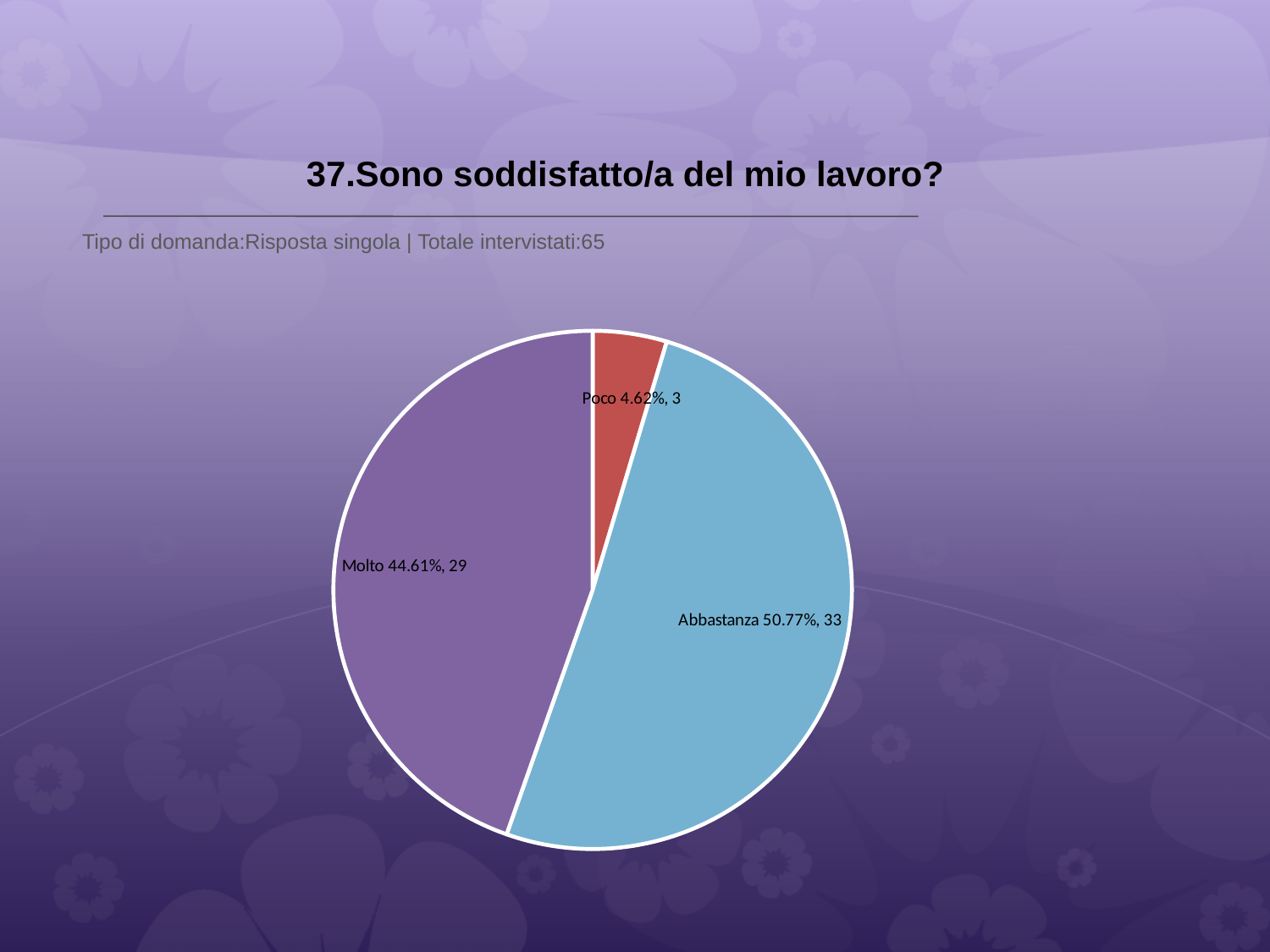
Which response has the smallest slice of the pie? Poco What is the title of the chart on the slide? 37.Sono soddisfatto/a del mio lavoro? What is the difference in respondent count between Abbastanza and Molto? 4 Which response has the largest slice of the pie? Abbastanza How many slices does the pie chart have? 3 What percentage share does the Molto slice have? 44.61% How many respondents answered Molto? 29 What percentage share does the Poco slice have? 4.62% How many respondents answered Poco? 3 How many respondents answered Abbastanza? 33 What percentage share does the Abbastanza slice have? 50.77% What kind of chart is shown on the slide? pie chart